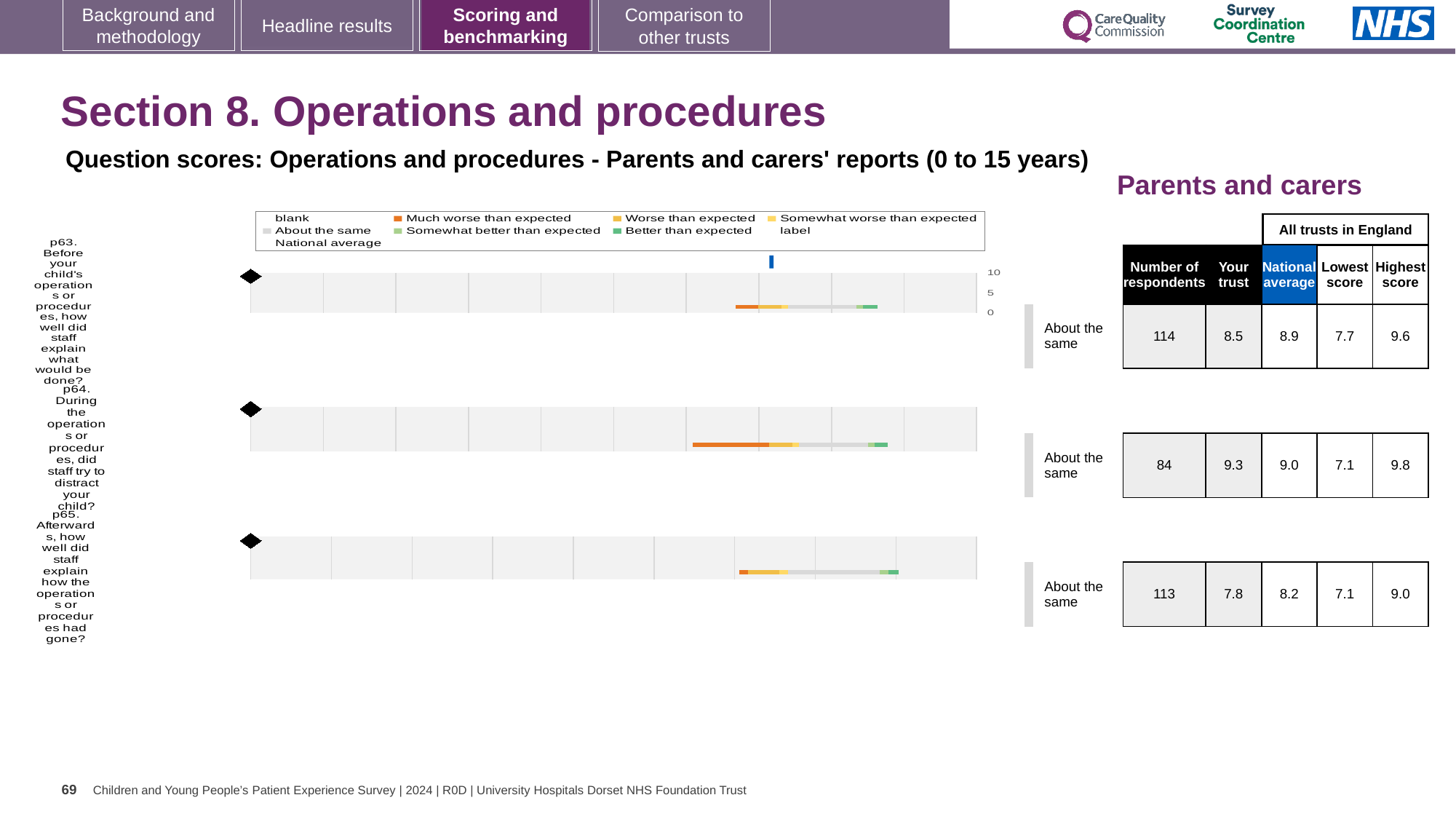
What is the highest score among all trusts in England for p64? 9.8 Which question has the highest 'Your trust' score on this slide? p64 What is the national average score for p63 (Before your child's operations or procedures, how well did staff explain what would be done?)? 8.9 How many respondents answered p65 (Afterwards, how well did staff explain how the operations or procedures had gone?)? 113 How many questions are shown on this slide? 3 What is the 'Your trust' score for p64 (During the operations or procedures, did staff try to distract your child?)? 9.3 For p63, which is larger: the 'Your trust' score or the national average? National average What benchmark category is shown for p65? About the same What is the lowest score among all trusts in England for p63? 7.7 For p65, what is the difference between the highest score and the lowest score among all trusts in England? 1.9 For p64, what is the difference between the 'Your trust' score and the national average? 0.3 Which question has the lowest 'Your trust' score on this slide? p65